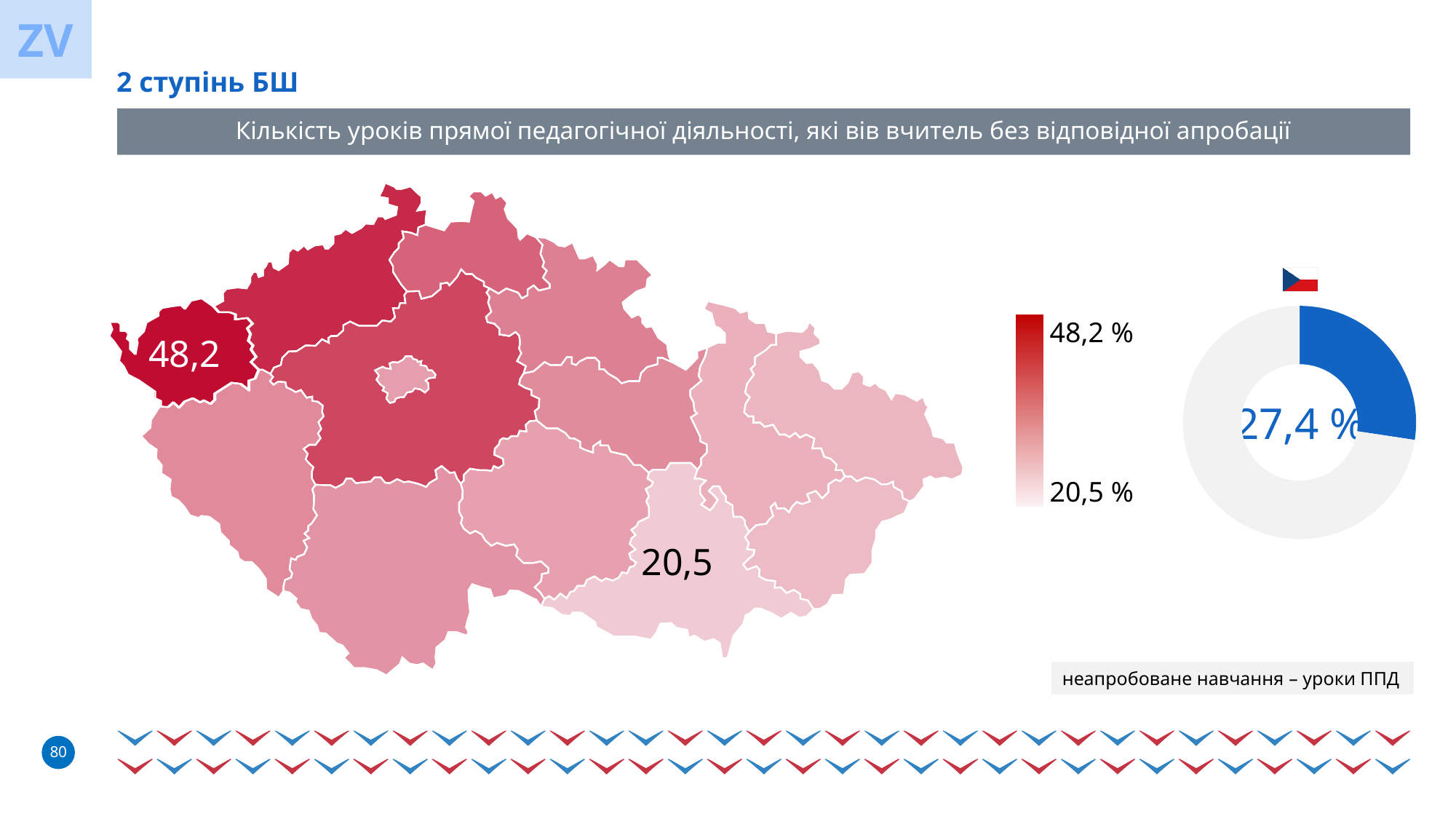
On the map chart, what is the difference between the highest labelled value (48,2) and the lowest labelled value (20,5)? 27,7 On the donut chart on the right, is the highlighted share greater or less than 50%? less On the map chart, what is the bottom value of the colour scale legend? 20,5 % On the map chart, which labelled value is larger: the one in the western region or the one in the south-eastern region? the western region (48,2) On the map chart, what is the top value of the colour scale legend? 48,2 % On the donut chart on the right, what percentage is shown in the centre? 27,4 % What kind of chart is shown on the left side of the slide? map (choropleth) chart What kind of chart is shown on the right side of the slide? donut (pie) chart What is the title shown in the grey bar above the charts? Кількість уроків прямої педагогічної діяльності, які вів вчитель без відповідної апробації On the map chart, what is the highest value shown as a data label? 48,2 On the map chart, what is the lowest value shown as a data label? 20,5 What does the legend text below the donut chart say? неапробоване навчання – уроки ППД